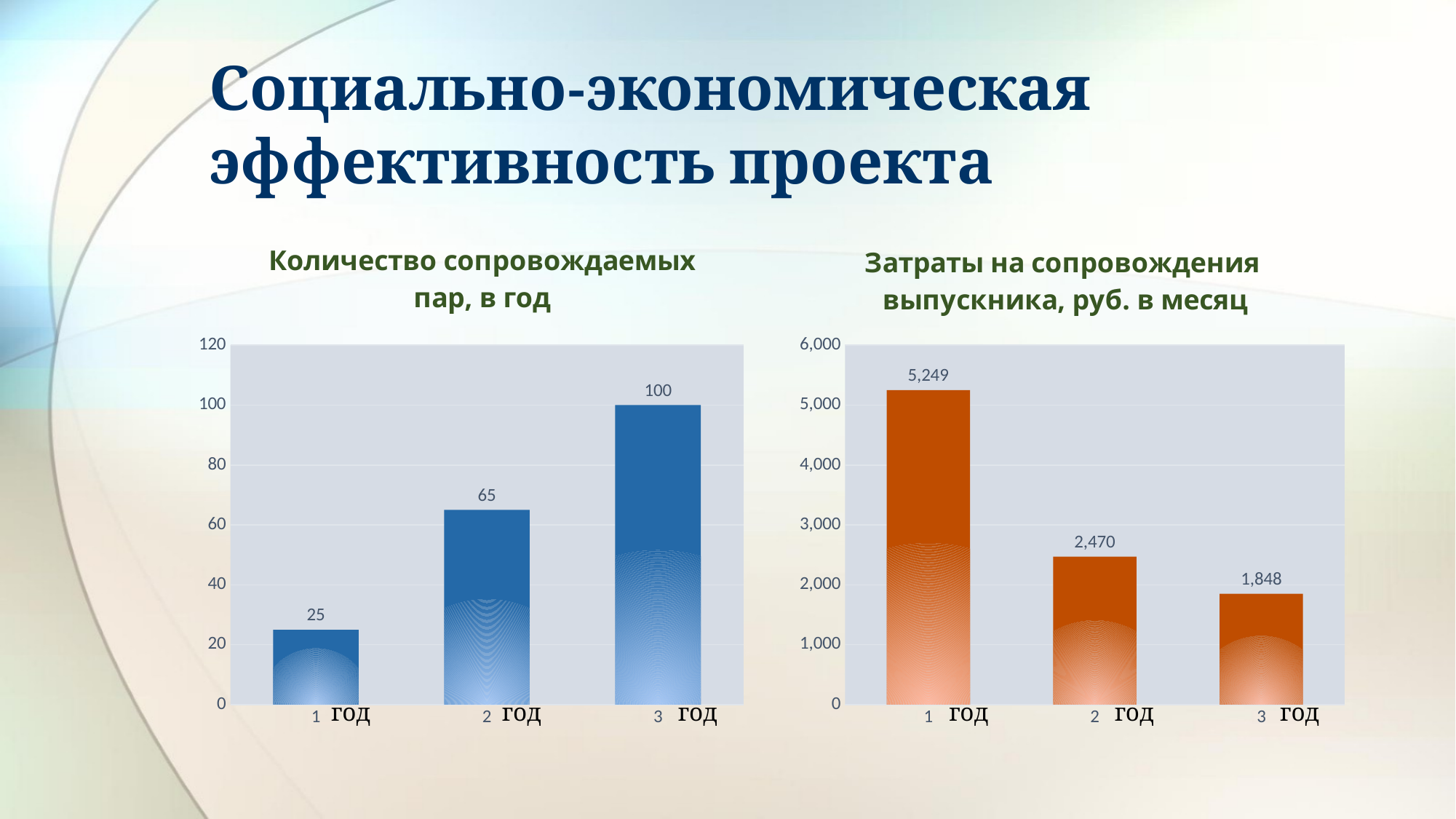
In the chart 'Количество сопровождаемых пар, в год', which year has the highest value? 3 год In the chart 'Затраты на сопровождения выпускника, руб. в месяц', what is the value for 2 год? 2,470 In the chart 'Затраты на сопровождения выпускника, руб. в месяц', which year has the lowest value? 3 год In the chart 'Затраты на сопровождения выпускника, руб. в месяц', what is the difference between the values for 1 год and 2 год? 2,779 In the chart 'Количество сопровождаемых пар, в год', what is the value for 3 год? 100 In the chart 'Количество сопровождаемых пар, в год', what is the value for 1 год? 25 In the chart 'Затраты на сопровождения выпускника, руб. в месяц', which is larger: the value for 1 год or 3 год? 1 год In the chart 'Затраты на сопровождения выпускника, руб. в месяц', what is the value for 3 год? 1,848 In the chart 'Количество сопровождаемых пар, в год', do the values rise or fall from 1 год to 3 год? rise What type of chart is the chart on the right, 'Затраты на сопровождения выпускника, руб. в месяц'? bar chart In the chart 'Количество сопровождаемых пар, в год', what is the difference between the values for 3 год and 2 год? 35 In the chart 'Затраты на сопровождения выпускника, руб. в месяц', do the values rise or fall from 1 год to 3 год? fall